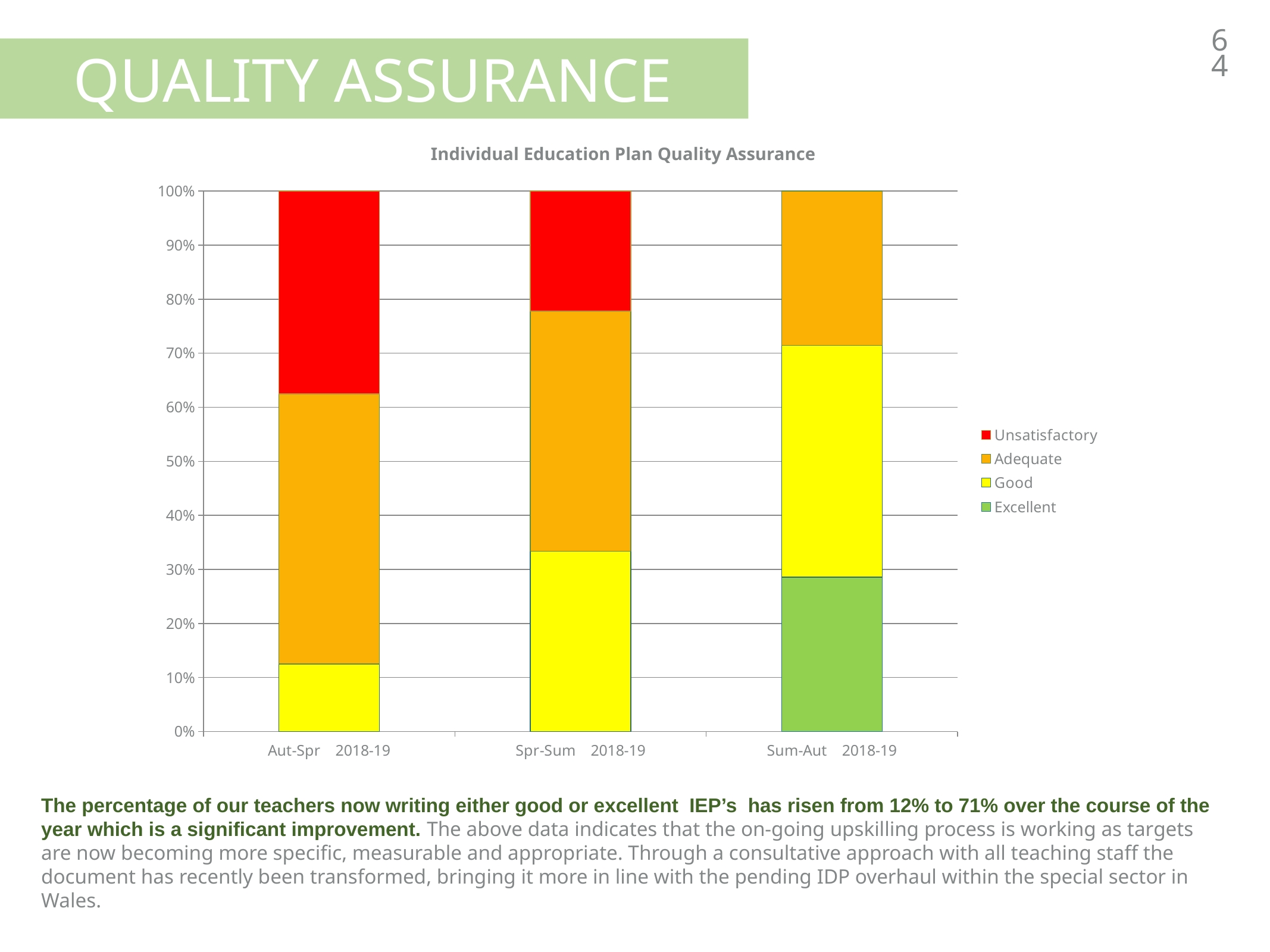
Is the Good share for Sum-Aut 2018-19 greater or less than 40%? greater Is the Unsatisfactory share for Aut-Spr 2018-19 greater or less than 30%? greater Which period has the largest Unsatisfactory segment? Aut-Spr 2018-19 In which period does the Excellent series first appear? Sum-Aut 2018-19 Is the Excellent share for Sum-Aut 2018-19 greater or less than 20%? greater Which is larger: the Adequate share in Aut-Spr 2018-19 or in Sum-Aut 2018-19? Aut-Spr 2018-19 What is the title of the chart? Individual Education Plan Quality Assurance How many series does the legend list? 4 Does the Unsatisfactory share rise or fall from Aut-Spr 2018-19 to Sum-Aut 2018-19? Fall Which period has the smallest Good segment? Aut-Spr 2018-19 How many periods (bars) are shown on the x axis? 3 What kind of chart is shown on the slide? Stacked bar chart